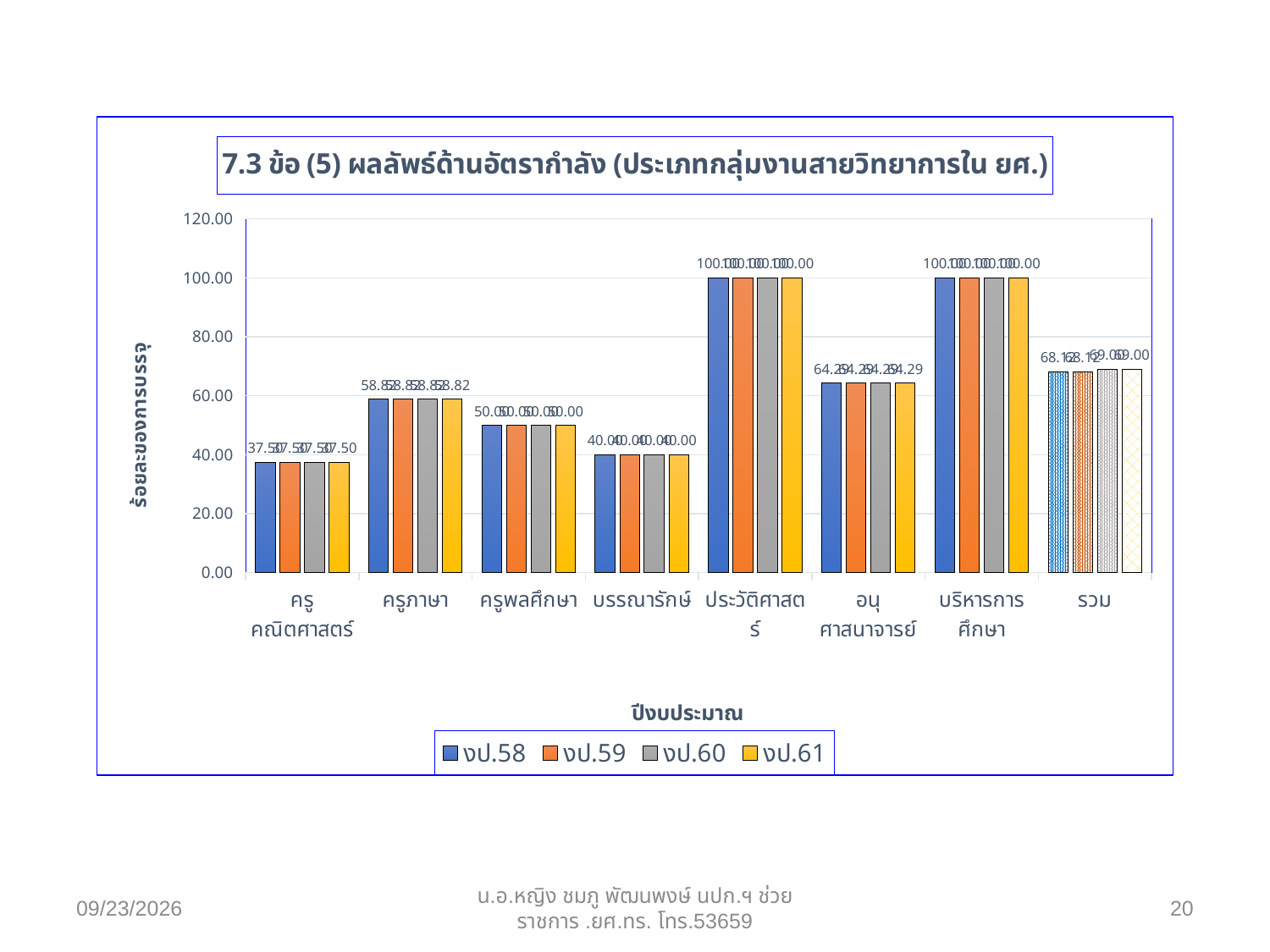
Which category has the lowest value in the งป.59 series? ครูคณิตศาสตร์ What is the title of the vertical axis? ร้อยละของการบรรจุ How many categories are shown on the x axis? 8 What is the value for อนุศาสนาจารย์ in the งป.61 series? 64.29 What is the difference between the งป.58 values for ครูภาษา and ครูคณิตศาสตร์? 21.32 In the งป.60 series, which is larger: อนุศาสนาจารย์ or ครูพลศึกษา? อนุศาสนาจารย์ How many series does the legend list? 4 What is the value for บรรณารักษ์ in the งป.60 series? 40.00 Is the value for รวม in the งป.61 series greater or less than 60.00? greater What is the value for ประวัติศาสตร์ in the งป.59 series? 100.00 What is the value for ครูภาษา in the งป.58 series? 58.82 What kind of chart is shown on the slide? bar chart